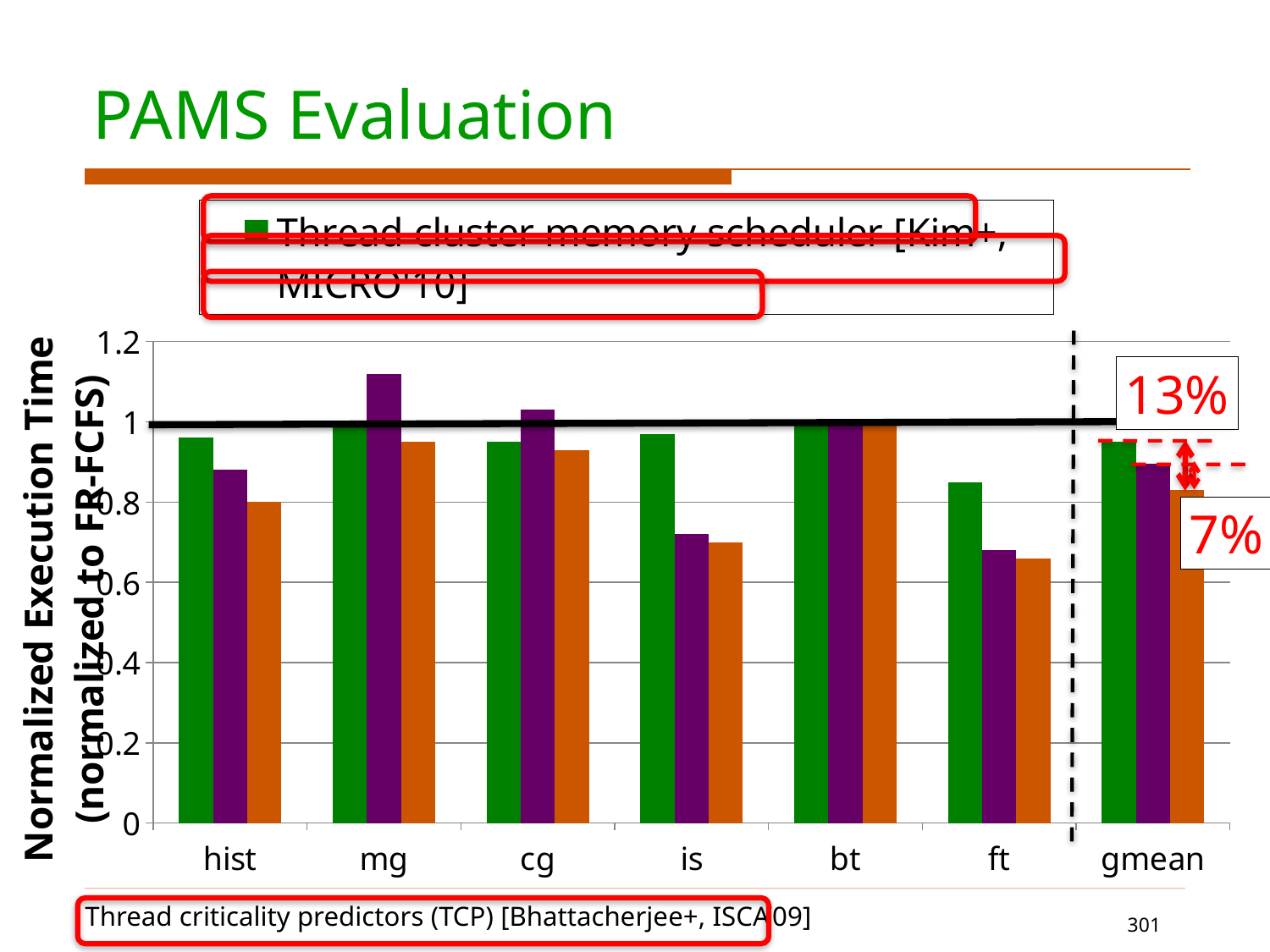
For ft, which is larger: the green bar or the orange bar? green bar Is the green bar for hist greater or less than 1? less Is the orange bar for ft greater or less than 0.8? less For mg, which is larger: the purple bar or the orange bar? purple bar What kind of chart is shown on the slide? bar chart What percentage annotation is shown above the gmean bars? 13% Which category has the lowest green bar? ft Which category has the highest purple bar? mg How many categories are shown along the x axis? 7 What is the y-axis label of the chart? Normalized Execution Time (normalized to FR-FCFS) Is the purple bar for is greater or less than 0.8? less